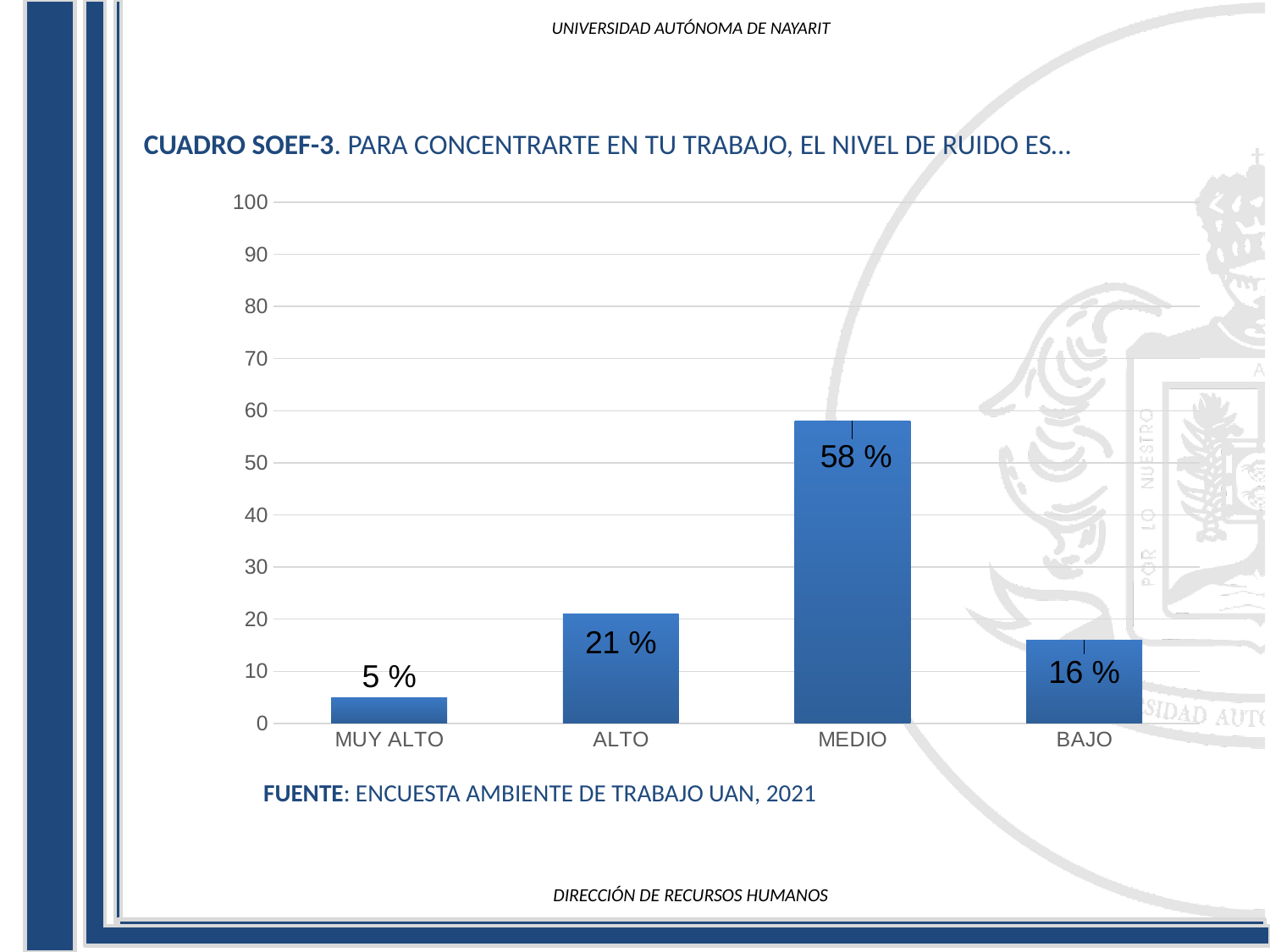
Which category has the lowest value? MUY ALTO What is the difference between the values for MEDIO and ALTO? 37 % What is the value for MEDIO? 58 % Is the value for MEDIO greater or less than 50? greater Which category has the highest value? MEDIO What is the value for BAJO? 16 % What is the value for ALTO? 21 % What is the value for MUY ALTO? 5 % What kind of chart is shown on the slide? bar chart How many categories are shown on the x axis? 4 Which is larger, the value for ALTO or the value for BAJO? ALTO What source is cited below the chart? ENCUESTA AMBIENTE DE TRABAJO UAN, 2021